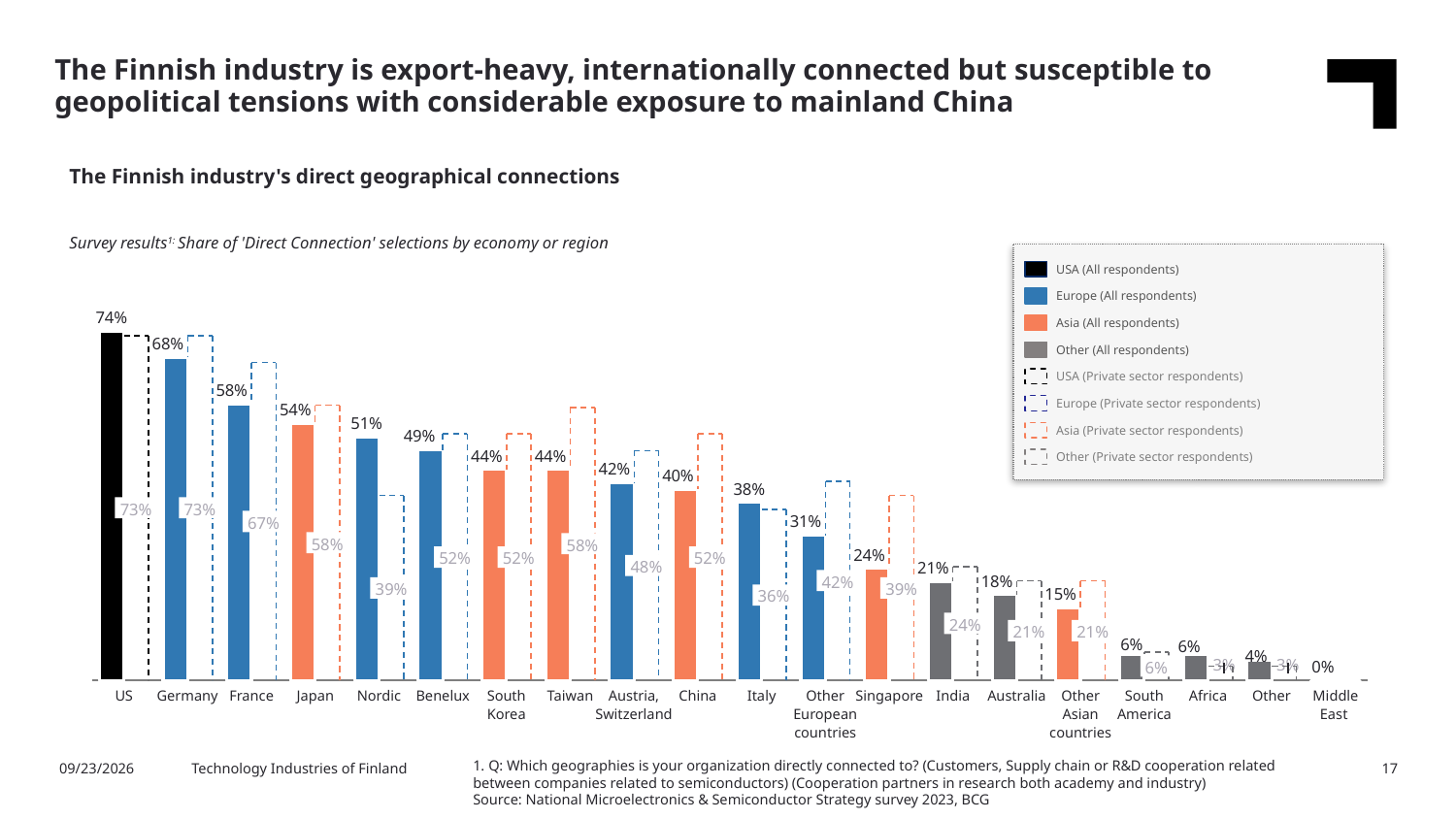
What is the value for Germany among private sector respondents? 73% Which is larger among all respondents: the value for Japan or the value for Taiwan? Japan How many series does the legend list? 8 What is the value for Nordic among private sector respondents? 39% What is the value for China among all respondents? 40% Which economy or region has the lowest share among all respondents? Middle East What is the difference between the all-respondents values for Germany and France? 10% What is the share of 'Direct Connection' selections for the US among all respondents? 74% Do the all-respondents values rise or fall moving from left to right along the x axis? Fall How many economies or regions are shown on the x axis? 20 What kind of chart is shown on the slide? Bar chart Which economy or region has the highest share among all respondents? US